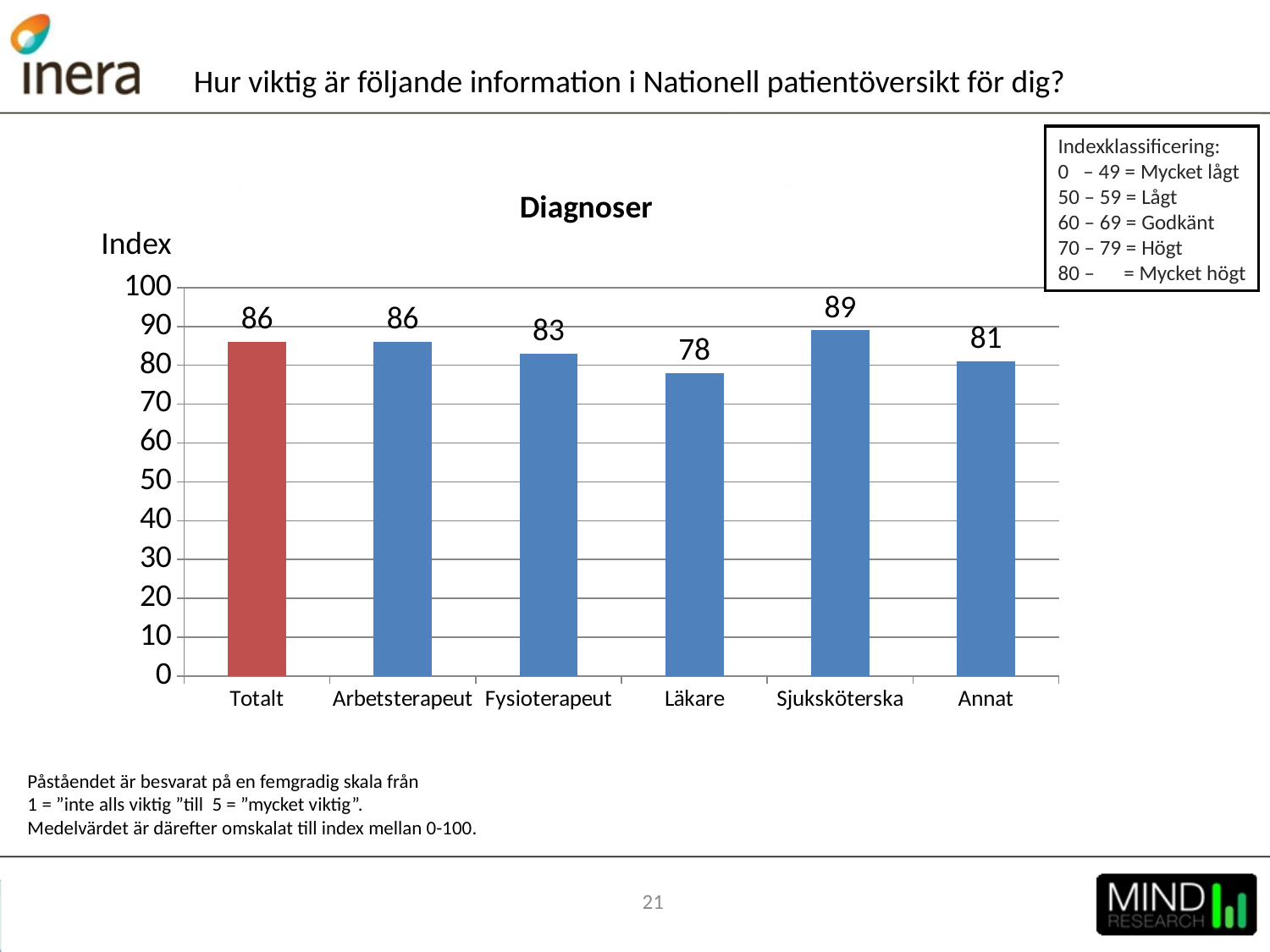
What is the index value for Sjuksköterska? 89 What is the index value for Läkare? 78 Which bar is coloured red rather than blue? Totalt Which category has the highest index value? Sjuksköterska What is the index value for Totalt? 86 What is the title of the chart? Diagnoser What is the difference between the index values for Sjuksköterska and Läkare? 11 Which category has the lowest index value? Läkare How many categories are shown on the x axis? 6 What kind of chart is shown on the slide? Bar chart Which has a higher index value, Fysioterapeut or Annat? Fysioterapeut What is the index value for Annat? 81